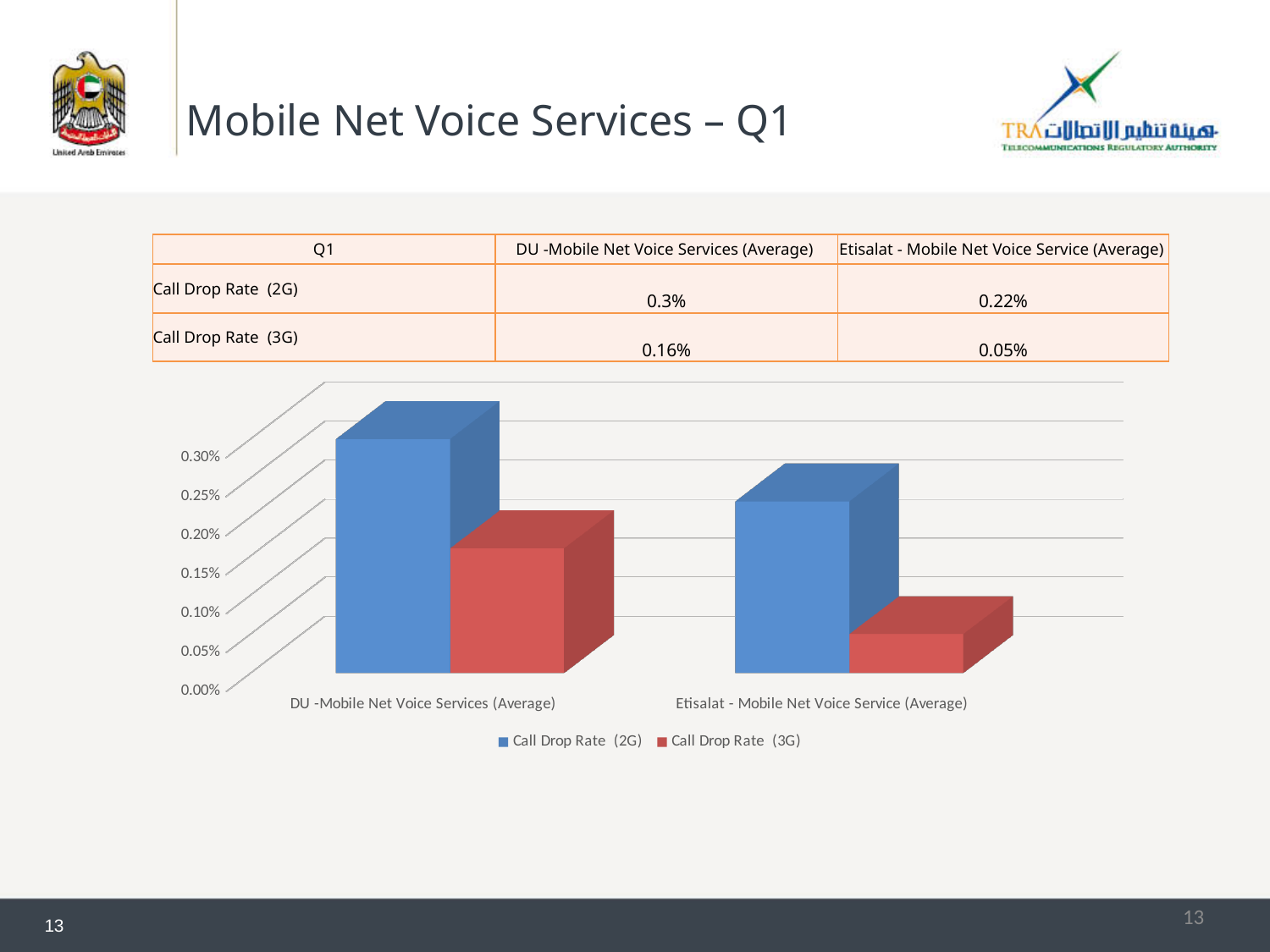
What is the Call Drop Rate (3G) for DU - Mobile Net Voice Services (Average)? 0.16% What is the difference between the Call Drop Rate (2G) for DU and for Etisalat? 0.08% Is the Call Drop Rate (3G) bar for Etisalat greater or less than 0.10%? less What is the Call Drop Rate (3G) for Etisalat - Mobile Net Voice Service (Average)? 0.05% How many categories are shown on the x axis of the chart? 2 Which operator has the lowest Call Drop Rate (3G)? Etisalat - Mobile Net Voice Service (Average) What is the Call Drop Rate (2G) for Etisalat - Mobile Net Voice Service (Average)? 0.22% What kind of chart is shown on the slide? bar chart How many series does the chart legend list? 2 Which operator has the higher Call Drop Rate (2G)? DU - Mobile Net Voice Services (Average) What is the Call Drop Rate (2G) for DU - Mobile Net Voice Services (Average)? 0.3% Which colour represents Call Drop Rate (3G) in the chart? red